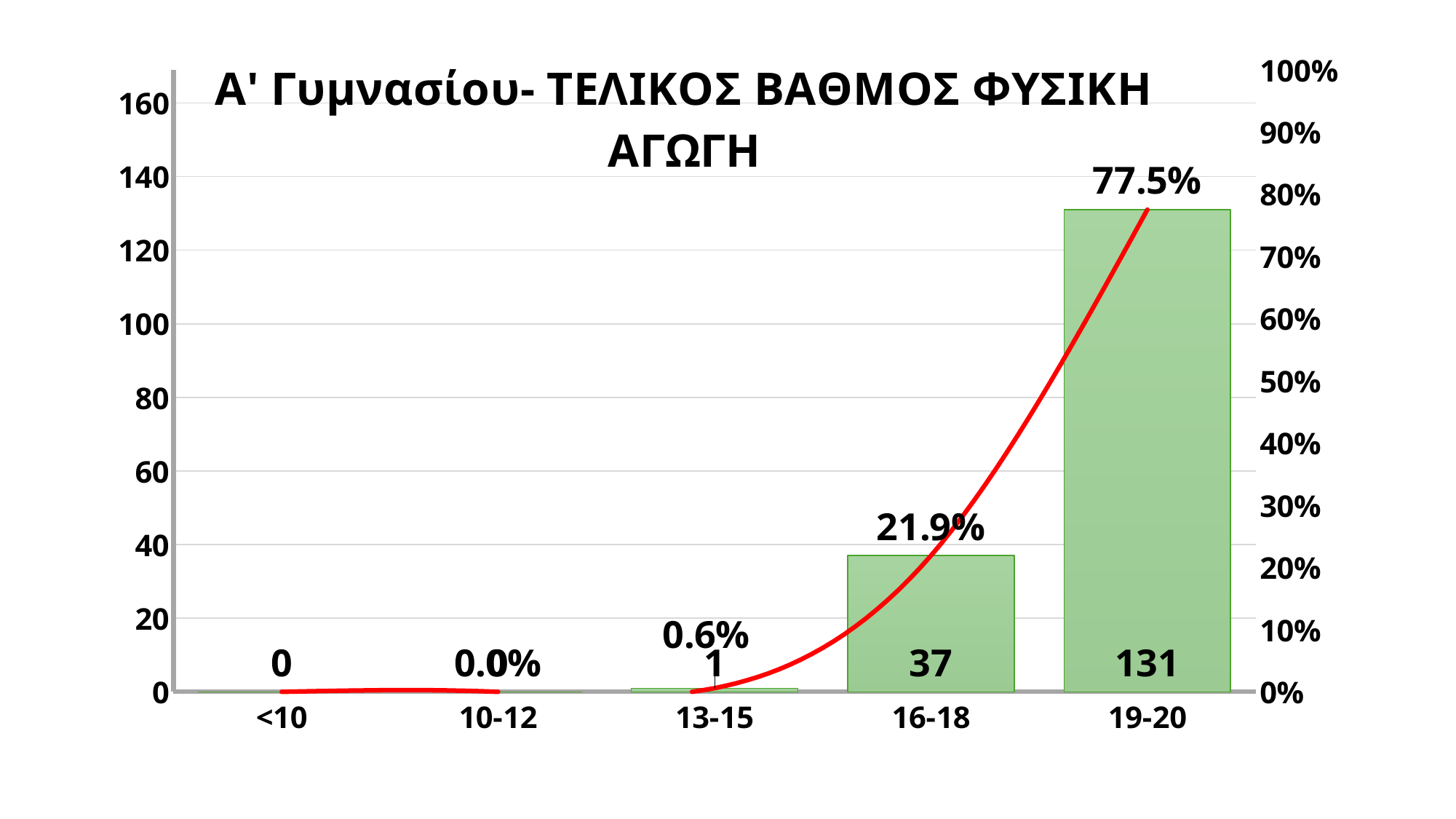
What is the count for the 13-15 category? 1 Do the counts rise or fall moving from left to right along the x axis? rise Which has a larger count, 16-18 or 13-15? 16-18 Is the count for 19-20 greater or less than 120? greater What is the count for the 16-18 category? 37 How many grade categories are shown on the x axis? 5 What percentage is shown for the 16-18 category? 21.9% What is the count for the 19-20 category? 131 What is the difference between the counts for 19-20 and 16-18? 94 What percentage is shown for the 19-20 category? 77.5% Which category has the highest count? 19-20 What percentage is shown for the 13-15 category? 0.6%